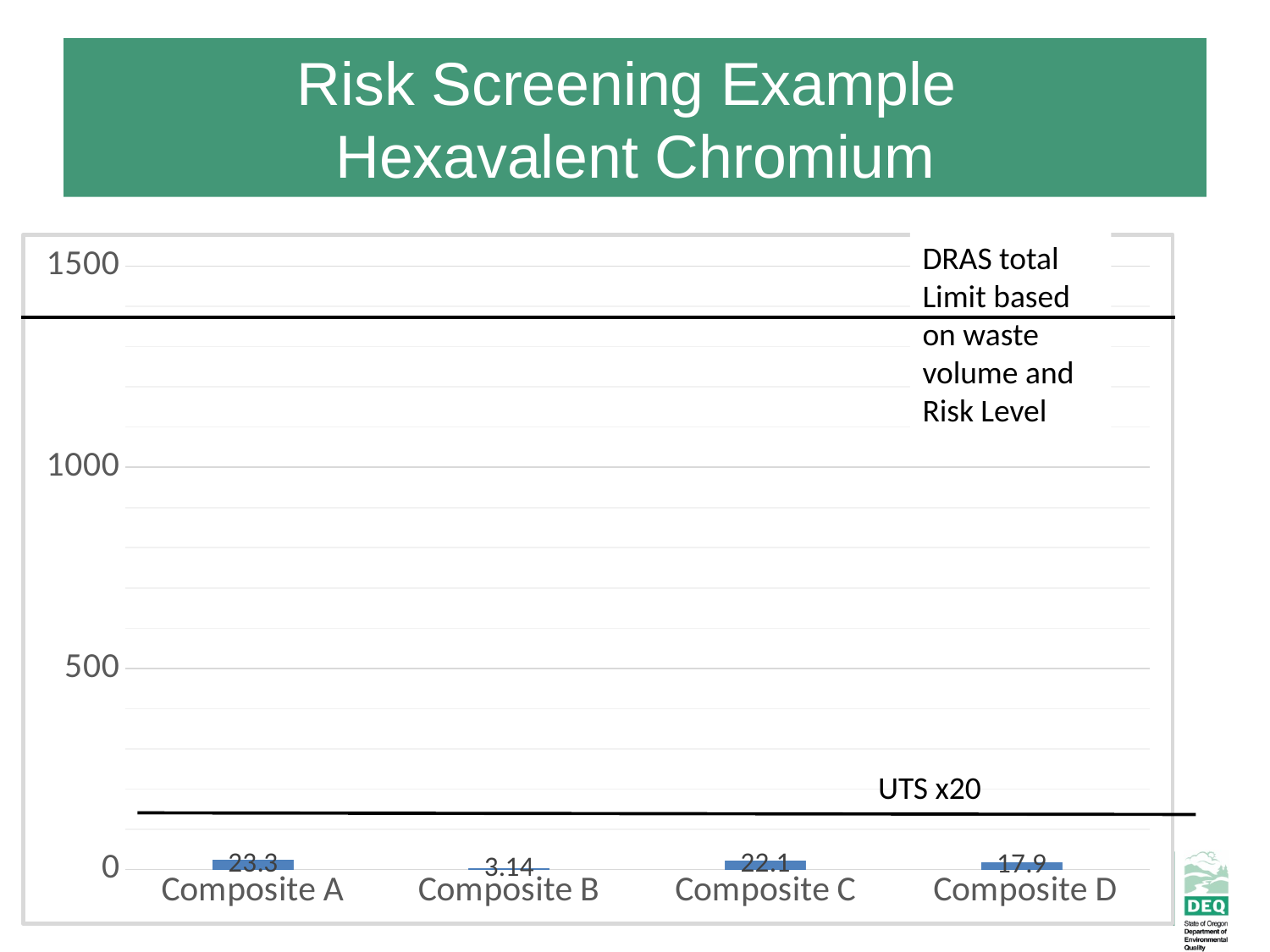
What kind of chart is shown on the slide? bar chart How many composites are plotted on the chart? 4 What is the value for Composite B? 3.14 Which composite has the lowest value? Composite B What is the label of the lower horizontal reference line on the chart? UTS x20 Which is larger, the value for Composite C or the value for Composite D? Composite C What is the value for Composite D? 17.9 What is the value for Composite C? 22.1 Which composite has the highest value? Composite A What is the difference between the values for Composite A and Composite B? 20.16 Is the value for Composite A greater or less than 500? less What is the value for Composite A? 23.3